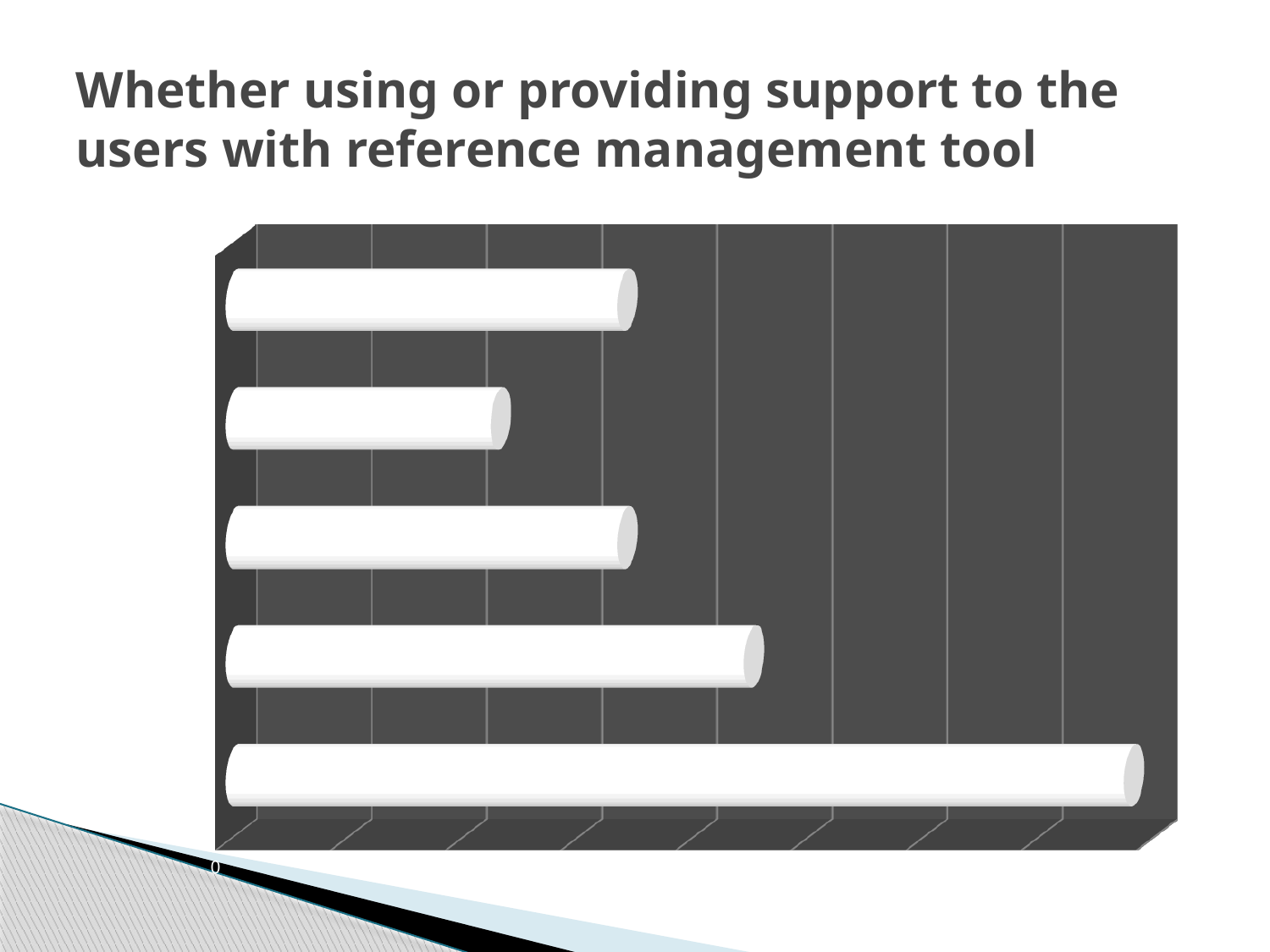
Which bar is the shortest: the top bar, the second bar, the third bar, the fourth bar, or the bottom bar? the second bar Which is longer, the bottom bar or the top bar? the bottom bar What is the title of the chart on the slide? Whether using or providing support to the users with reference management tool How many bars does the chart contain? 5 Which bar is the longest: the top bar, the second bar, the third bar, the fourth bar, or the bottom bar? the bottom bar What kind of chart is shown on the slide? bar chart What colour are the bars in the chart? white Which is longer, the fourth bar from the top or the second bar from the top? the fourth bar from the top